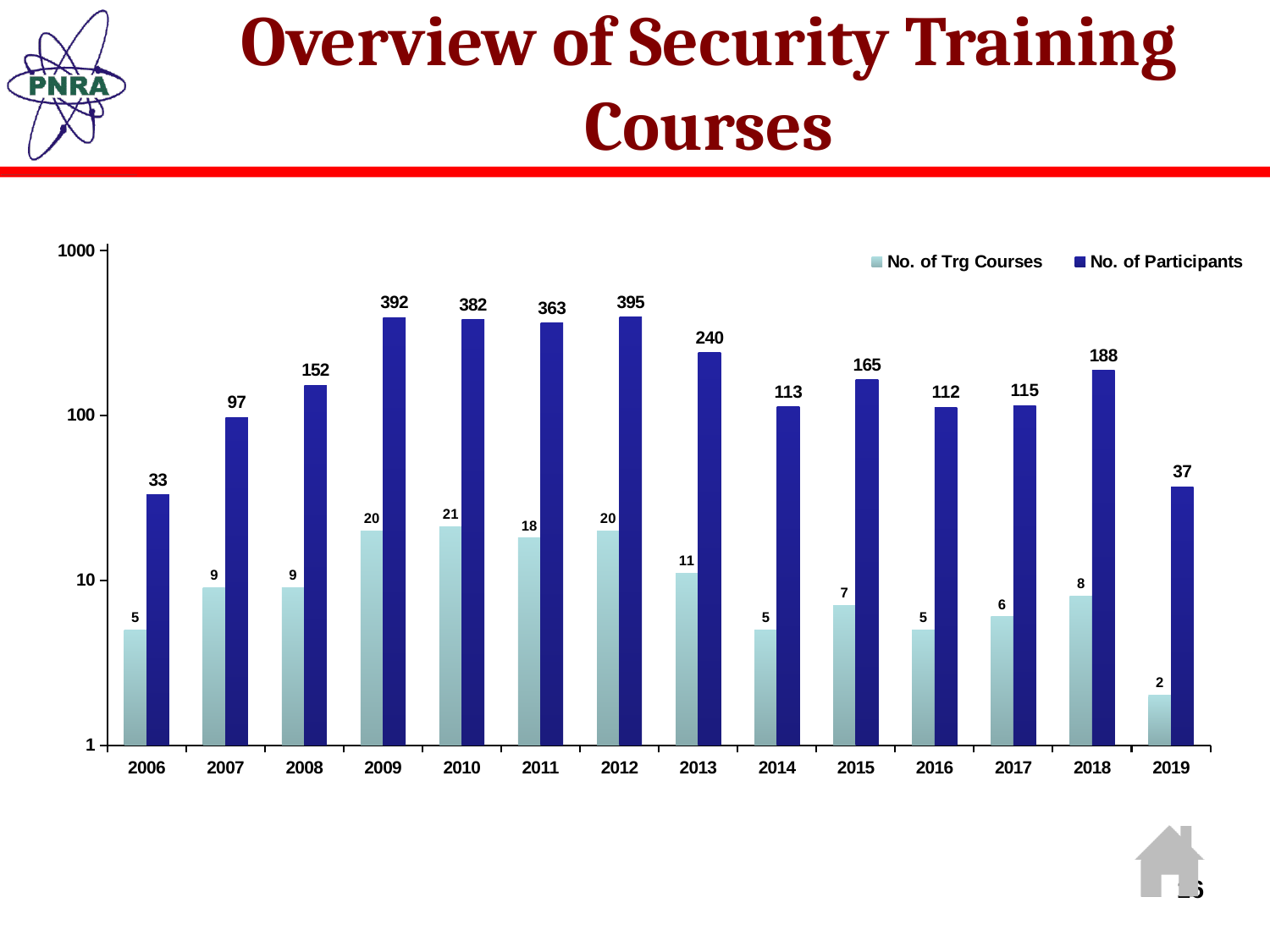
What kind of chart is shown on the slide? bar chart Which year had the lowest number of training courses? 2019 Which year had more participants, 2015 or 2018? 2018 What is the difference in the number of participants between 2009 and 2008? 240 Did the number of participants rise or fall from 2012 to 2014? fall How many participants were there in 2012? 395 How many training courses were held in 2010? 21 Which year had the highest number of participants? 2012 Is the number of participants in 2013 greater or less than 100? greater How many years are shown on the x axis? 14 How many series does the legend list? 2 What is the highest value shown on the y axis? 1000